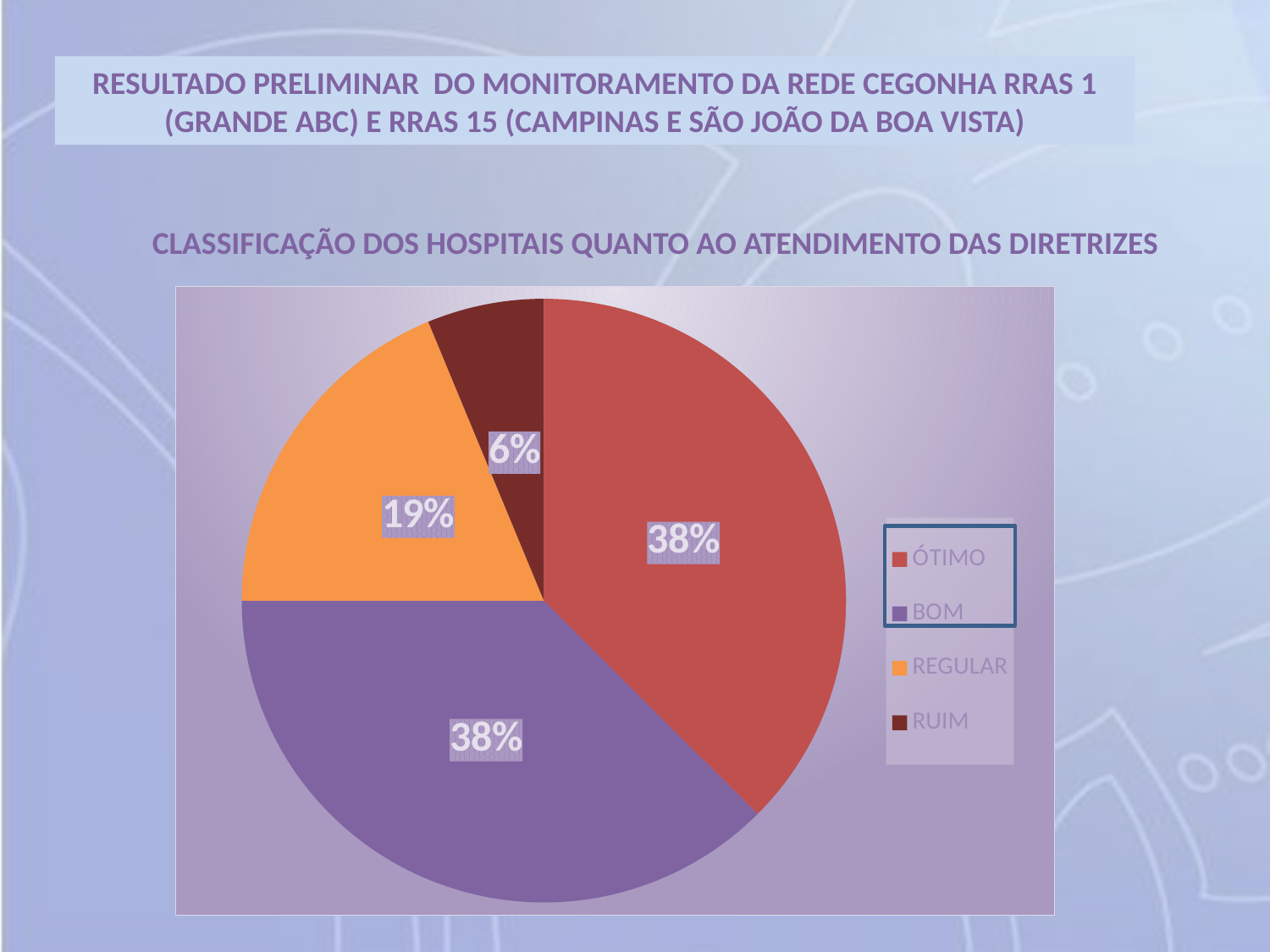
Which slice is larger, REGULAR or RUIM? REGULAR What share of the pie does the BOM slice represent? 38% What is the difference in percentage points between the REGULAR slice and the RUIM slice? 13 What share of the pie does the RUIM slice represent? 6% How many slices does the pie chart have? 4 What share of the pie does the ÓTIMO slice represent? 38% What kind of chart is shown on the slide? pie chart What is the difference in percentage points between the BOM slice and the REGULAR slice? 19 What is the title of the chart? CLASSIFICAÇÃO DOS HOSPITAIS QUANTO AO ATENDIMENTO DAS DIRETRIZES Which slice is larger, ÓTIMO or REGULAR? ÓTIMO Which category has the smallest slice of the pie? RUIM